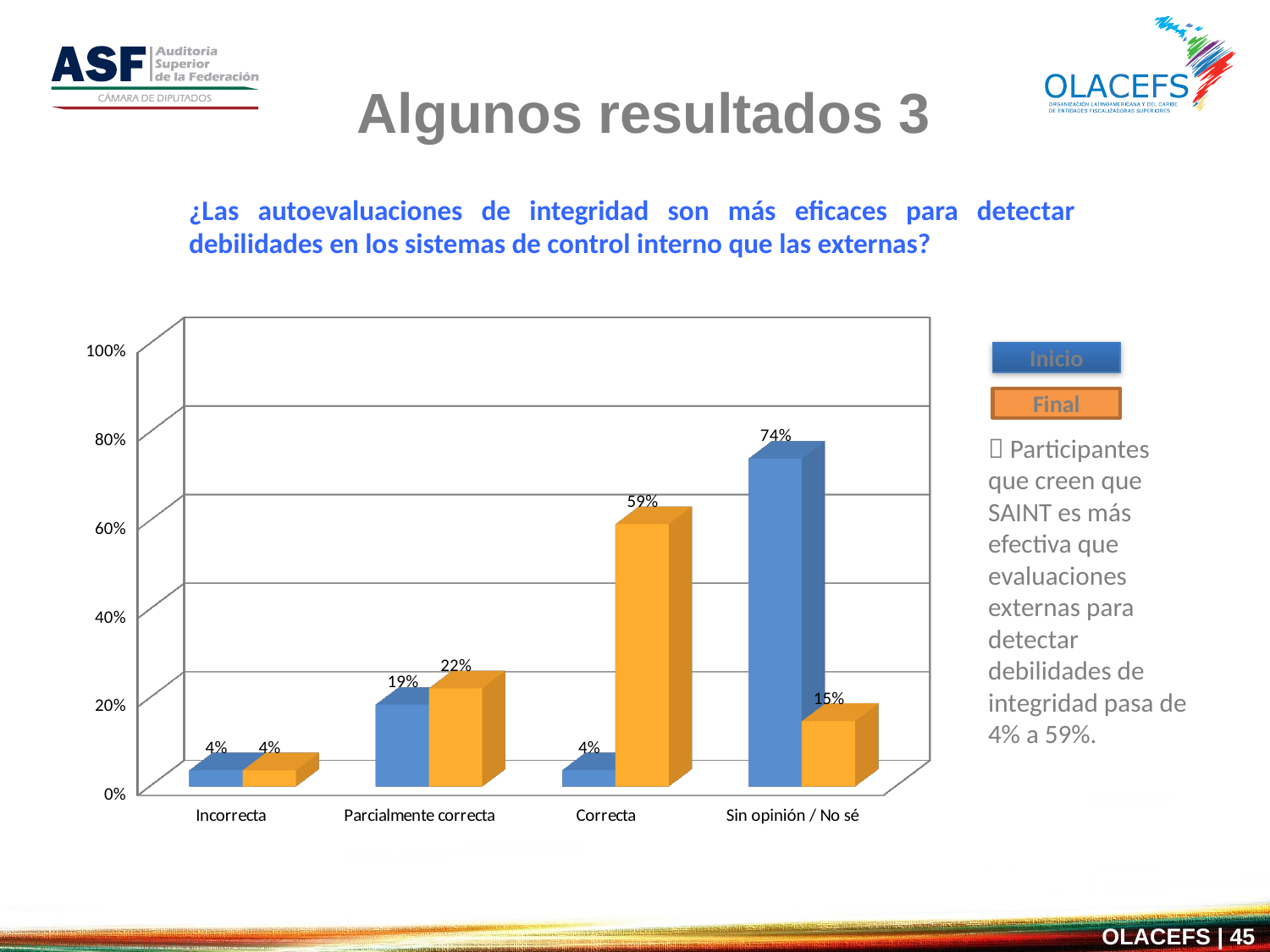
What is the Inicio value for Sin opinión / No sé? 74% What is the Final value for Parcialmente correcta? 22% Is the Final value for Correcta greater or less than 40%? greater What is the difference between the Final and Inicio values for Correcta? 55% What is the Inicio value for Correcta? 4% How many series does the legend list? 2 Which category has the lowest Final value? Incorrecta What kind of chart is shown on the slide? Bar chart Which is larger for Sin opinión / No sé, the Inicio value or the Final value? Inicio What is the Final value for Correcta? 59% Which category has the highest Inicio value? Sin opinión / No sé How many categories are shown on the x axis? 4